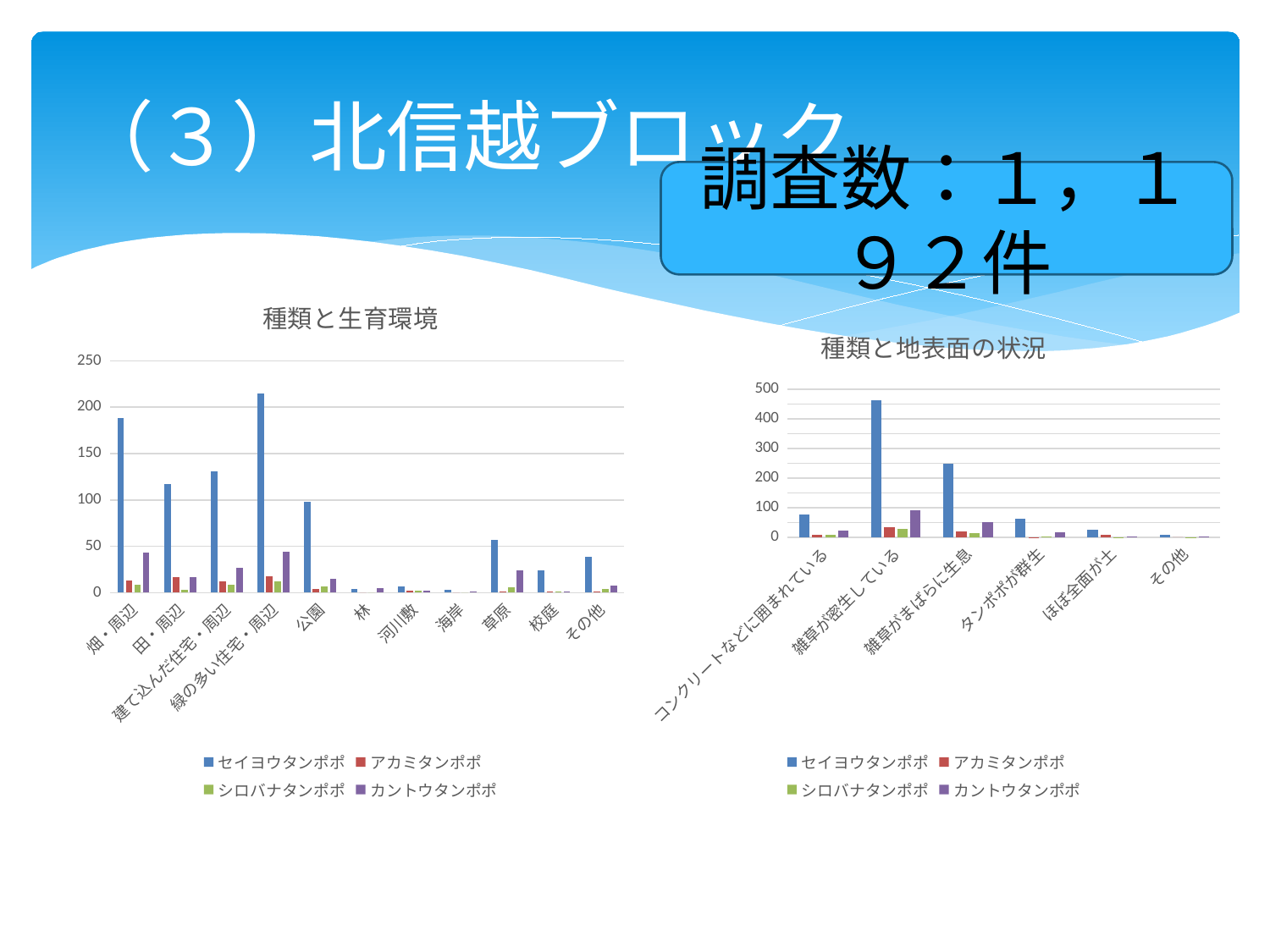
How many series does the legend of the chart titled 種類と地表面の状況 list? 4 In the chart titled 種類と生育環境, which category has the highest value for セイヨウタンポポ? 緑の多い住宅・周辺 In the chart titled 種類と地表面の状況, is the value for セイヨウタンポポ at 雑草が密生している greater or less than 400? greater In the chart titled 種類と地表面の状況, which category has the highest value for セイヨウタンポポ? 雑草が密生している In the chart titled 種類と生育環境, is the value for セイヨウタンポポ at 畑・周辺 greater or less than 150? greater What kind of chart is the chart titled 種類と生育環境? bar chart In the chart titled 種類と生育環境, is the value for セイヨウタンポポ at 緑の多い住宅・周辺 greater or less than 200? greater How many categories are shown on the x axis of the chart titled 種類と生育環境? 11 In the chart titled 種類と生育環境, which is larger for セイヨウタンポポ: 田・周辺 or 公園? 田・周辺 What is the title of the chart on the right side of the slide? 種類と地表面の状況 How many categories are shown on the x axis of the chart titled 種類と地表面の状況? 6